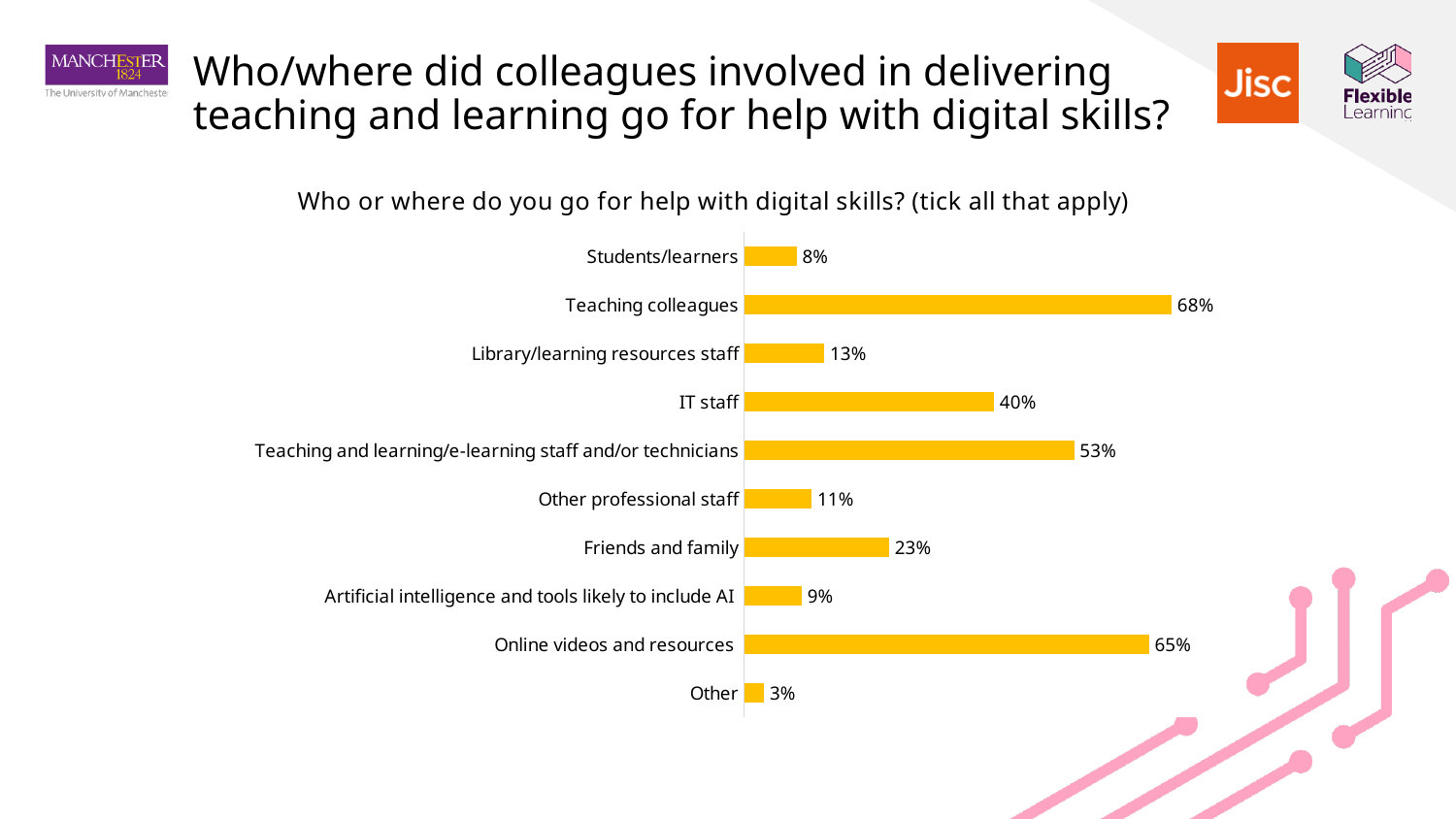
What percentage go to online videos and resources for help? 65% How many categories are shown in the chart? 10 Which category has the lowest value? Other Which is larger: the value for Teaching and learning/e-learning staff and/or technicians or the value for IT staff? Teaching and learning/e-learning staff and/or technicians What is the difference between the values for IT staff and Library/learning resources staff? 27% What is the difference between the values for Teaching colleagues and Online videos and resources? 3% What is the title of the chart? Who or where do you go for help with digital skills? (tick all that apply) What is the value for Friends and family? 23% Which category has the highest value? Teaching colleagues What kind of chart is shown on the slide? Bar chart What is the value for IT staff? 40% What percentage of respondents go to teaching colleagues for help with digital skills? 68%